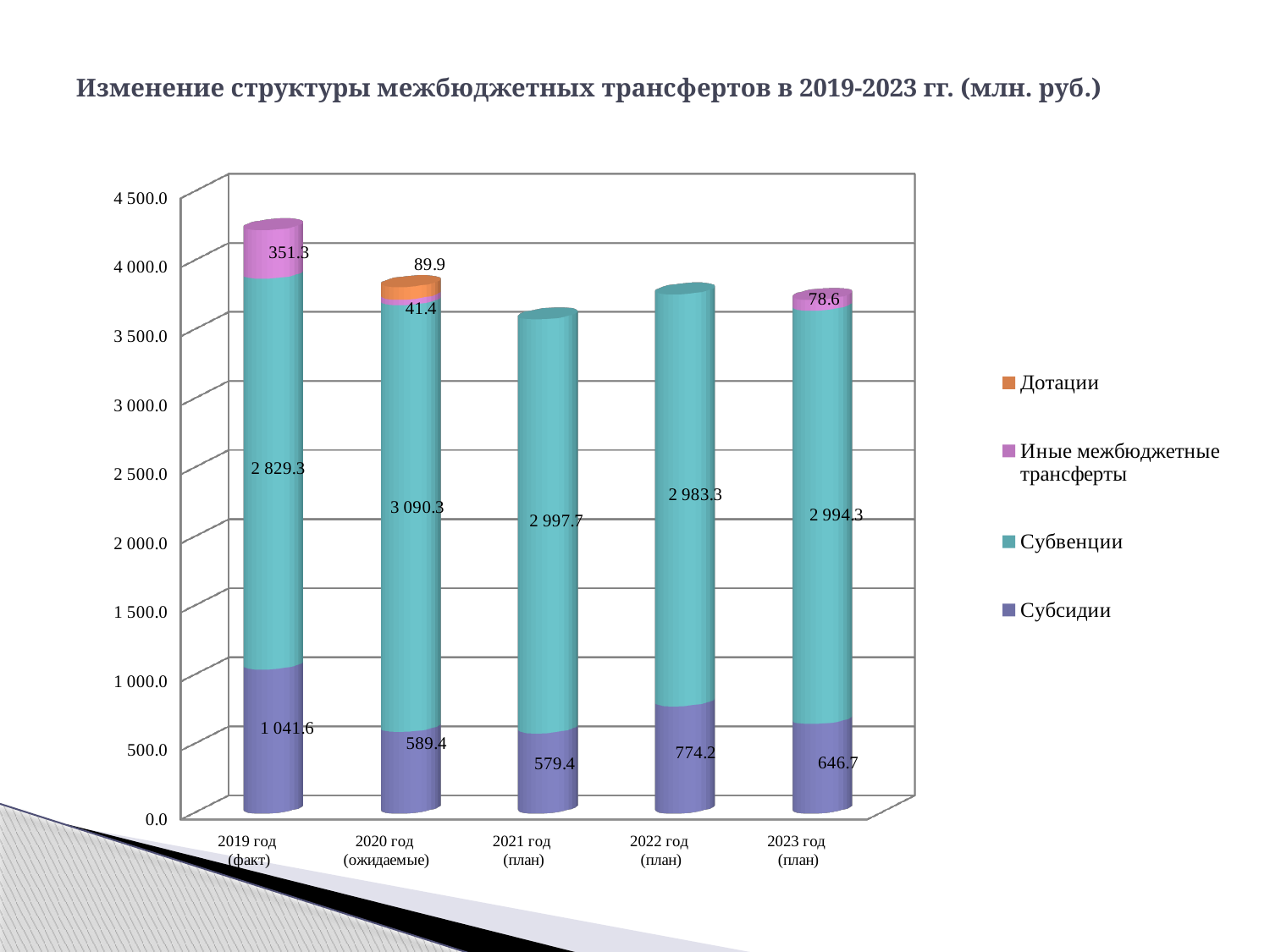
How many series does the legend list? 4 What is the total of the stacked bar for 2021 год (план)? 3 577.1 In which year is the Субсидии value the highest? 2019 год (факт) In which year is the Субсидии value the lowest? 2021 год (план) Which year has the larger Субвенции value, 2021 год (план) or 2023 год (план)? 2021 год (план) What is the value of Иные межбюджетные трансферты for 2023 год (план)? 78.6 What is the difference between the Субсидии values for 2022 год (план) and 2021 год (план)? 194.8 What is the value of Субсидии for 2019 год (факт)? 1 041.6 What is the value of Дотации for 2020 год (ожидаемые)? 89.9 What kind of chart is shown on the slide? Stacked bar chart How many years (categories) are shown on the x axis? 5 What is the value of Субвенции for 2020 год (ожидаемые)? 3 090.3